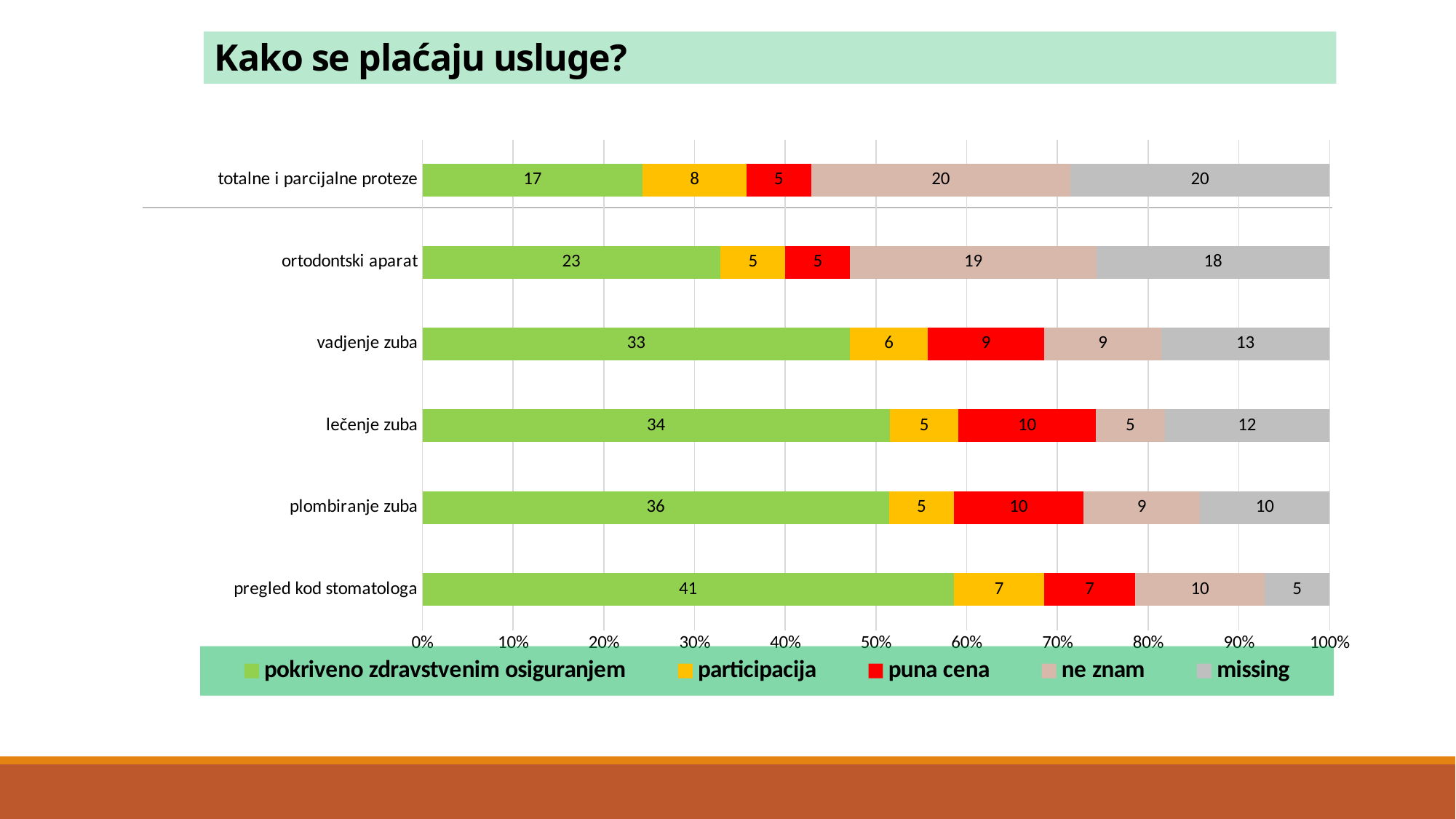
How many series does the legend list? 5 How many categories (services) are shown on the chart? 6 Which category has the lowest value for 'missing'? pregled kod stomatologa What is the value for 'ne znam' for 'ortodontski aparat'? 19 What is the title of the chart? Kako se plaćaju usluge? What is the difference between the 'pokriveno zdravstvenim osiguranjem' values for 'plombiranje zuba' and 'totalne i parcijalne proteze'? 19 What is the value for 'pokriveno zdravstvenim osiguranjem' for 'pregled kod stomatologa'? 41 What is the total of all segments in the bar for 'vadjenje zuba'? 70 Which category has the highest value for 'pokriveno zdravstvenim osiguranjem'? pregled kod stomatologa What is the value for 'puna cena' for 'lečenje zuba'? 10 What kind of chart is shown on the slide? stacked bar chart Which is larger: the 'missing' value for 'totalne i parcijalne proteze' or for 'vadjenje zuba'? totalne i parcijalne proteze